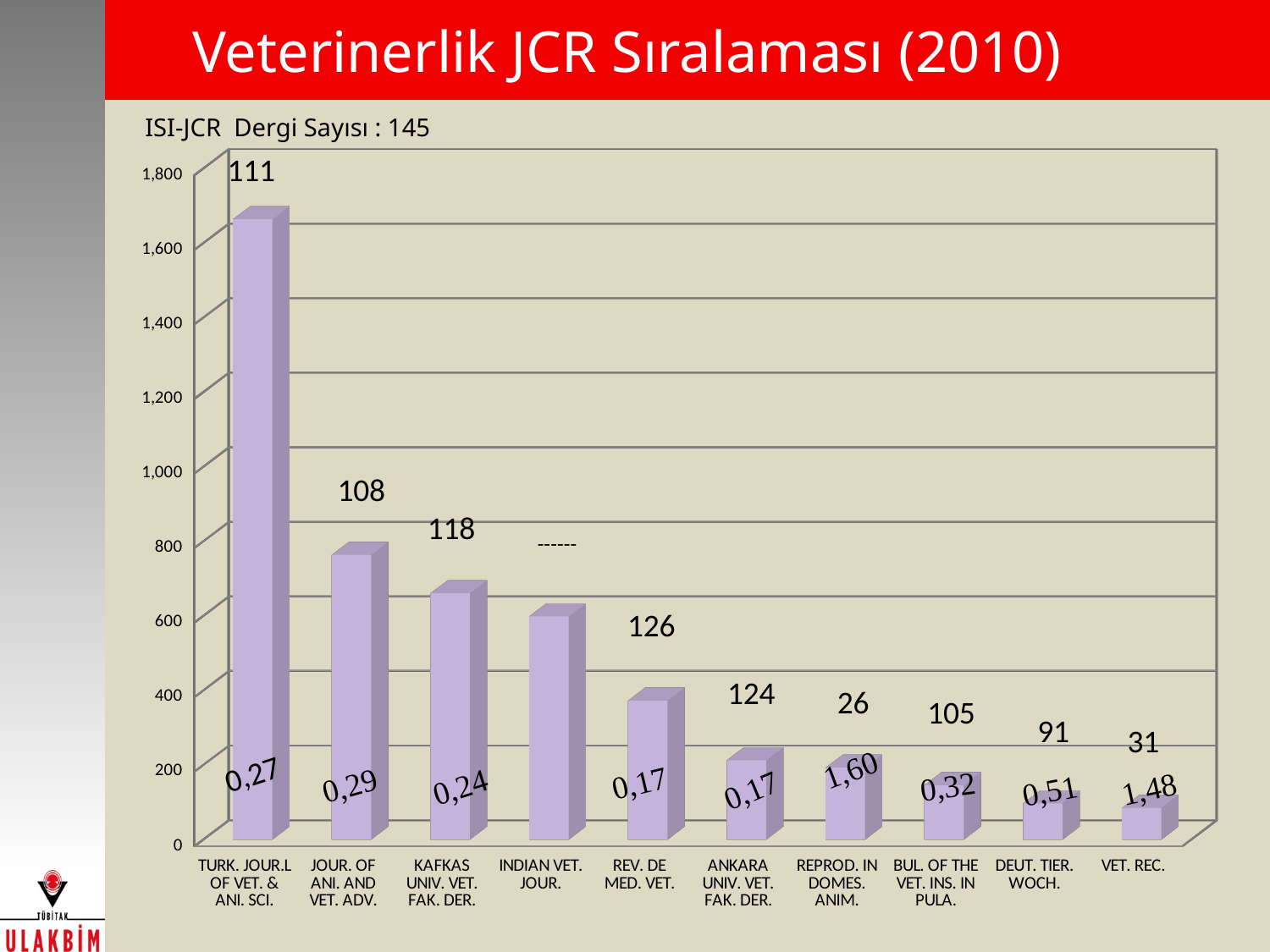
Is the value for REV. DE MED. VET. greater or less than 600? less Which has the larger value, KAFKAS UNIV. VET. FAK. DER. or REV. DE MED. VET.? KAFKAS UNIV. VET. FAK. DER. Do the bar values generally rise or fall from left to right along the x axis? fall What is the title of the slide containing the chart? Veterinerlik JCR Sıralaması (2010) Is the value for JOUR. OF ANI. AND VET. ADV. greater or less than 600? greater Is the value for TURK. JOUR.L OF VET. & ANI. SCI. greater or less than 1,400? greater Which journal has the tallest bar? TURK. JOUR.L OF VET. & ANI. SCI. Which journal has the shortest bar? VET. REC. How many journals (categories) are plotted on the x axis? 10 What kind of chart is shown on the slide? bar chart